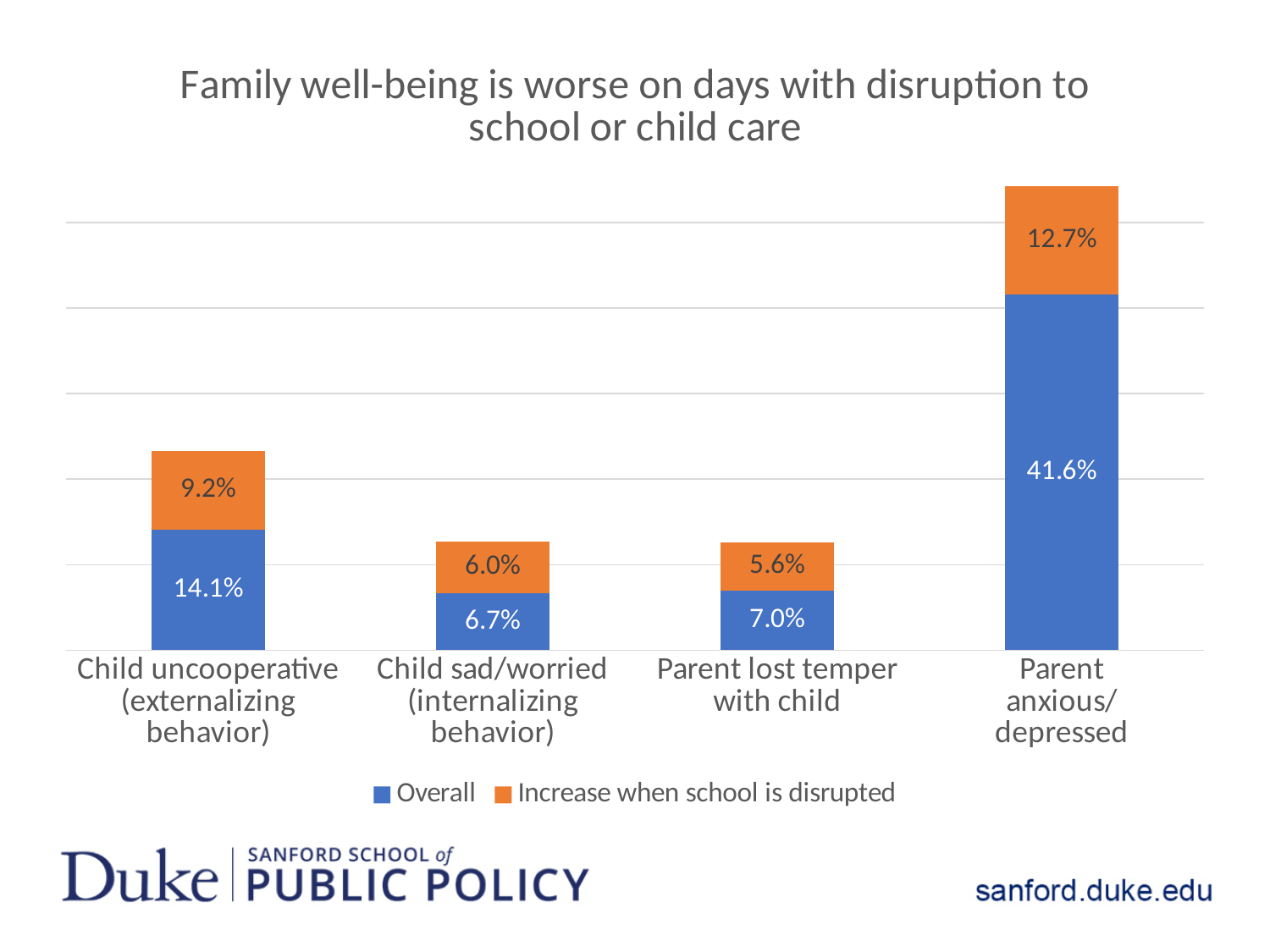
What is the Increase when school is disrupted value for Child sad/worried (internalizing behavior)? 6.0% What is the Overall value for Child uncooperative (externalizing behavior)? 14.1% How many categories are shown on the x axis? 4 What kind of chart is shown on the slide? Stacked bar chart Which is larger: the Increase when school is disrupted value for Child uncooperative (externalizing behavior) or for Parent lost temper with child? Child uncooperative (externalizing behavior) What is the Increase when school is disrupted value for Parent anxious/depressed? 12.7% What is the Overall value for Parent lost temper with child? 7.0% Which category has the highest Overall value? Parent anxious/depressed Which category has the lowest Increase when school is disrupted value? Parent lost temper with child What is the total of the stacked bar for Parent anxious/depressed? 54.3% How many series does the legend list? 2 What is the difference between the Overall values for Child uncooperative (externalizing behavior) and Child sad/worried (internalizing behavior)? 7.4%